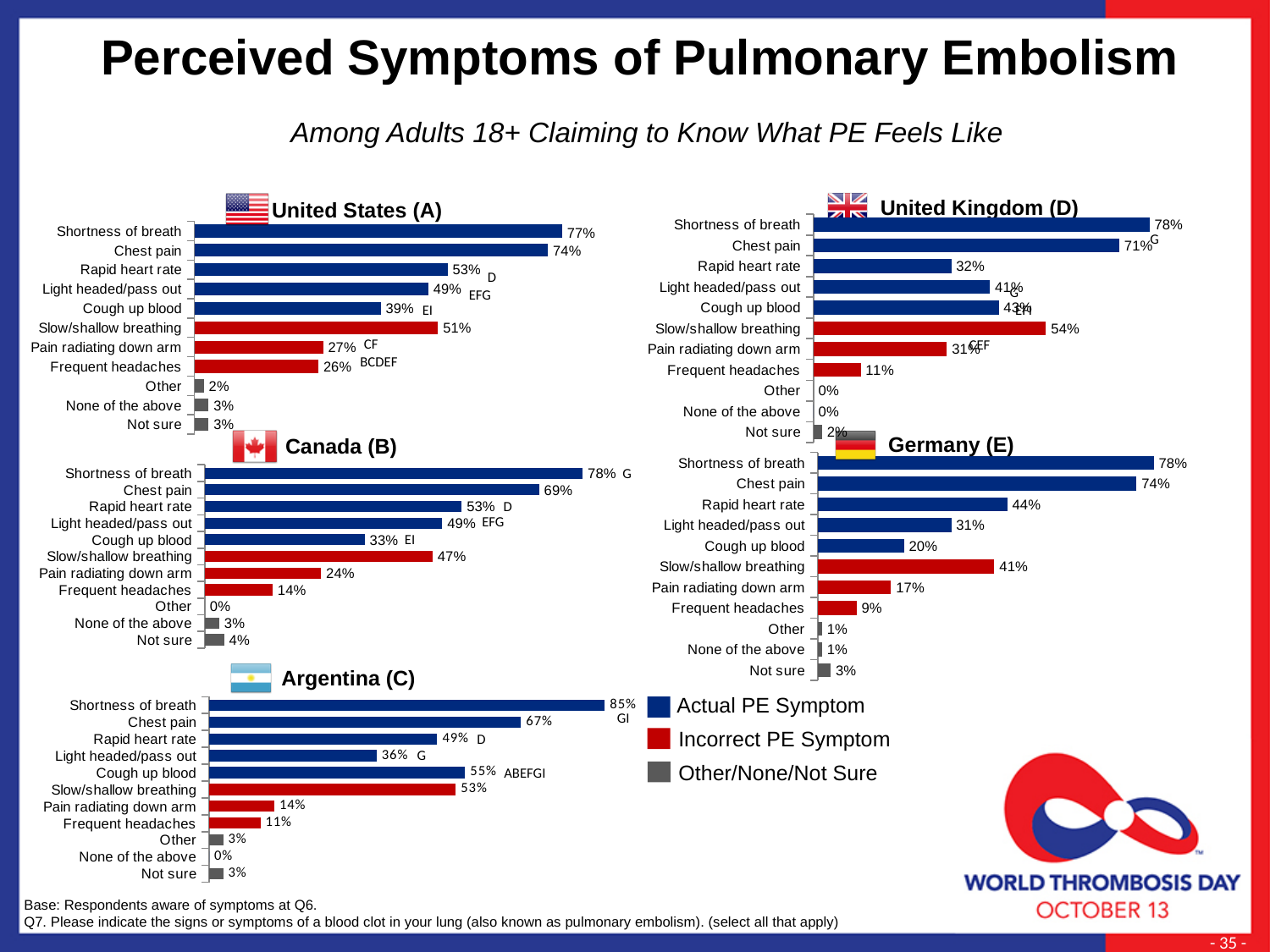
In the United States (A) chart, what percentage selected Shortness of breath? 77% According to the legend, what colour represents Incorrect PE Symptom? Red In the United States (A) chart, what is the difference between Shortness of breath and Chest pain? 3% What type of chart is used for the United Kingdom (D) data? Bar chart In the Argentina (C) chart, is the value for Shortness of breath greater or less than 80%? greater In the Germany (E) chart, which is larger: Rapid heart rate or Light headed/pass out? Rapid heart rate In the United Kingdom (D) chart, which symptom has the highest percentage? Shortness of breath In the Canada (B) chart, which category has the lowest percentage? Other In the Germany (E) chart, what percentage selected Slow/shallow breathing? 41% How many categories are listed in the Canada (B) chart? 11 In the Argentina (C) chart, what percentage selected Cough up blood? 55% How many entries does the legend on the slide list? 3